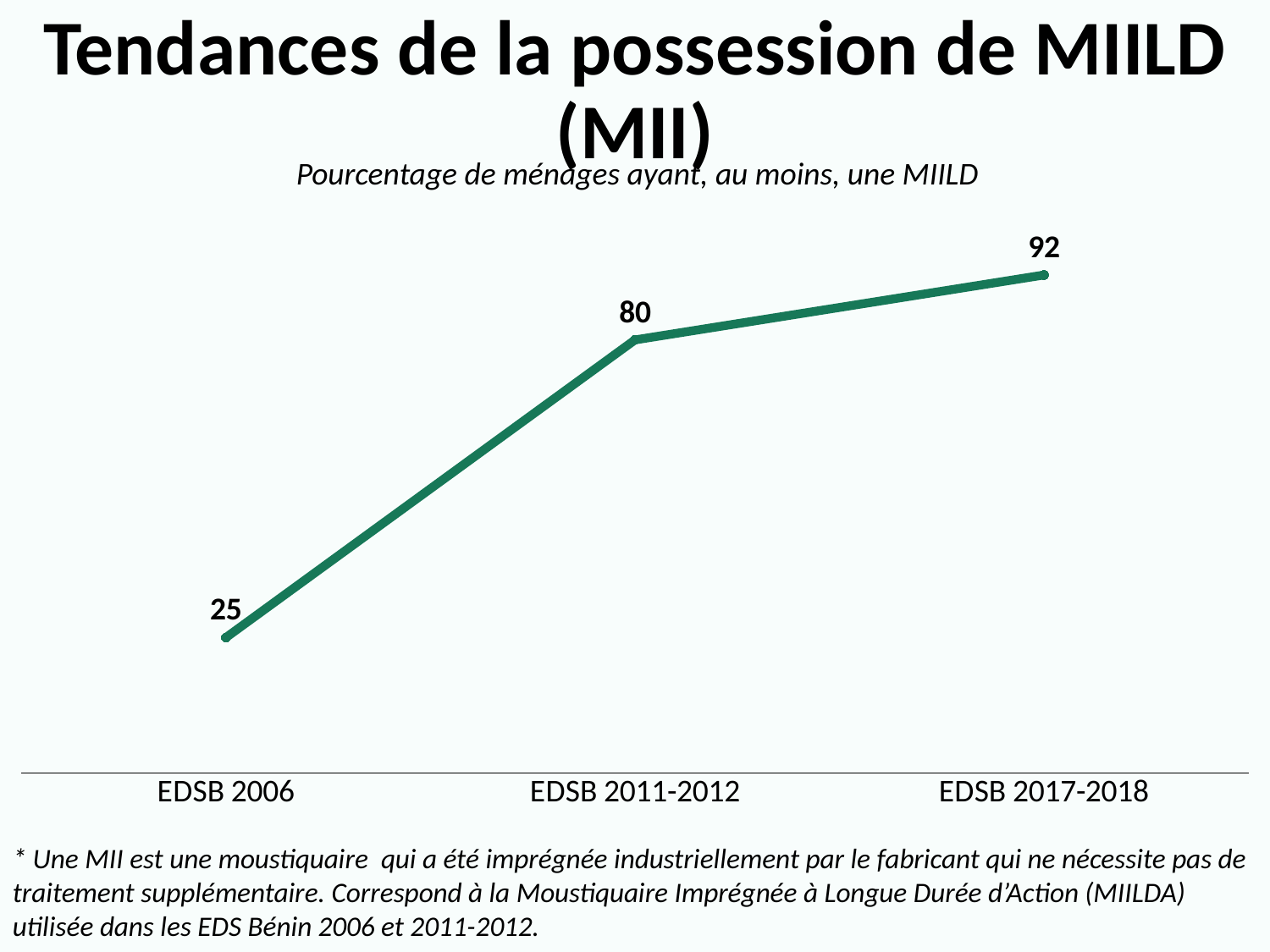
What is the difference between the values for EDSB 2017-2018 and EDSB 2011-2012? 12 What is the value for EDSB 2011-2012? 80 Do the values rise or fall from EDSB 2006 to EDSB 2017-2018? Rise What kind of chart is shown on the slide? Line chart What is the value for EDSB 2017-2018? 92 What is the value for EDSB 2006? 25 Which is larger, the value for EDSB 2006 or the value for EDSB 2011-2012? EDSB 2011-2012 Which survey has the highest value? EDSB 2017-2018 What is the difference between the values for EDSB 2011-2012 and EDSB 2006? 55 What is the subtitle of the chart? Pourcentage de ménages ayant, au moins, une MIILD Which survey has the lowest value? EDSB 2006 How many data points are plotted on the chart? 3